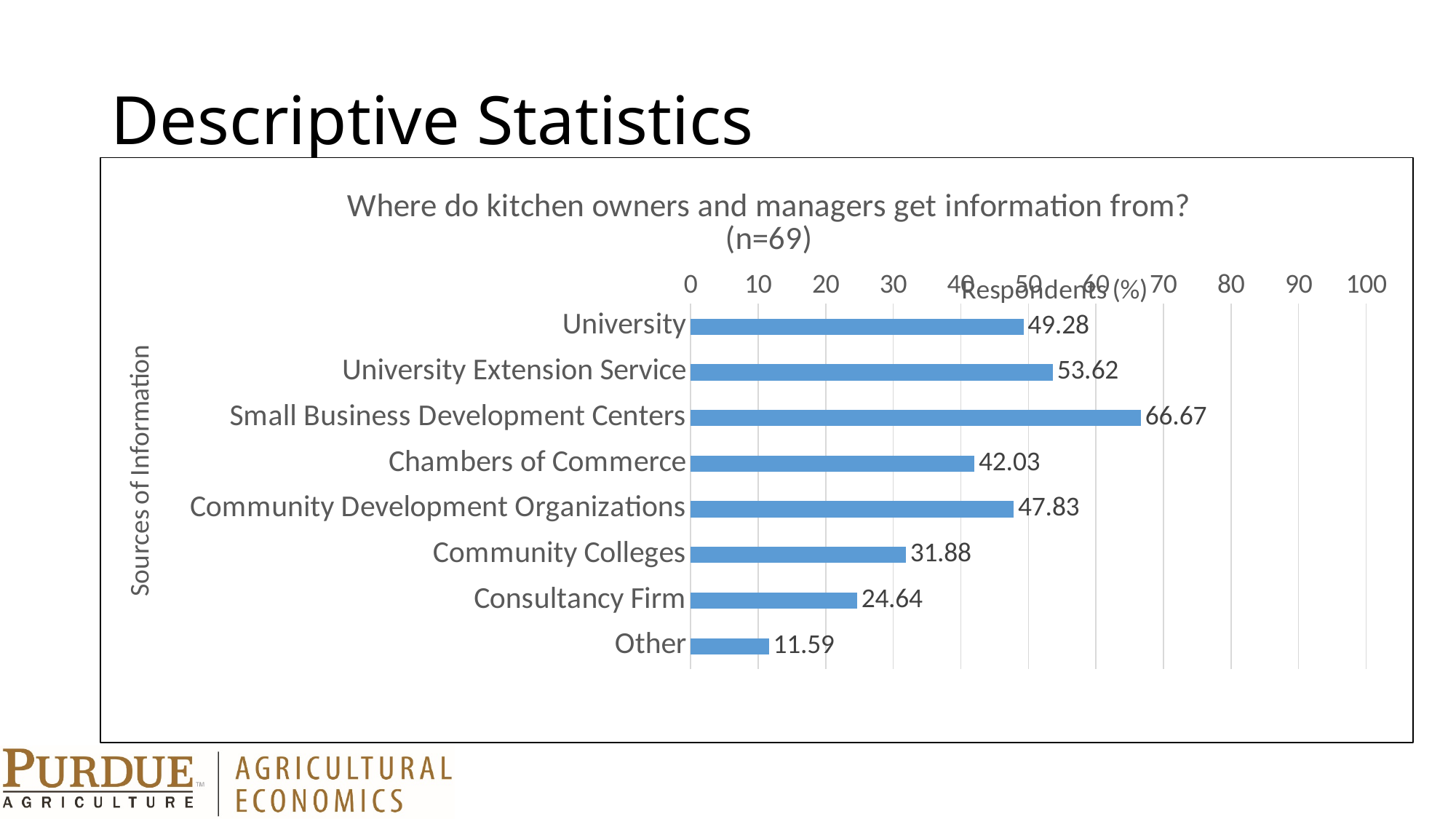
What is the value for University Extension Service? 53.62 Is the value for Community Colleges greater or less than 40? less What is the difference between the values for University Extension Service and University? 4.34 Which source of information has the lowest percentage of respondents? Other Which source of information has the highest percentage of respondents? Small Business Development Centers Which is larger, the value for Chambers of Commerce or the value for Community Development Organizations? Community Development Organizations What percentage of respondents get information from Small Business Development Centers? 66.67 What is the difference between the values for Community Colleges and Other? 20.29 How many sources of information are shown in the chart? 8 What is the value for Consultancy Firm? 24.64 What kind of chart is shown on the slide? bar chart What is the sample size (n) stated in the chart title? 69